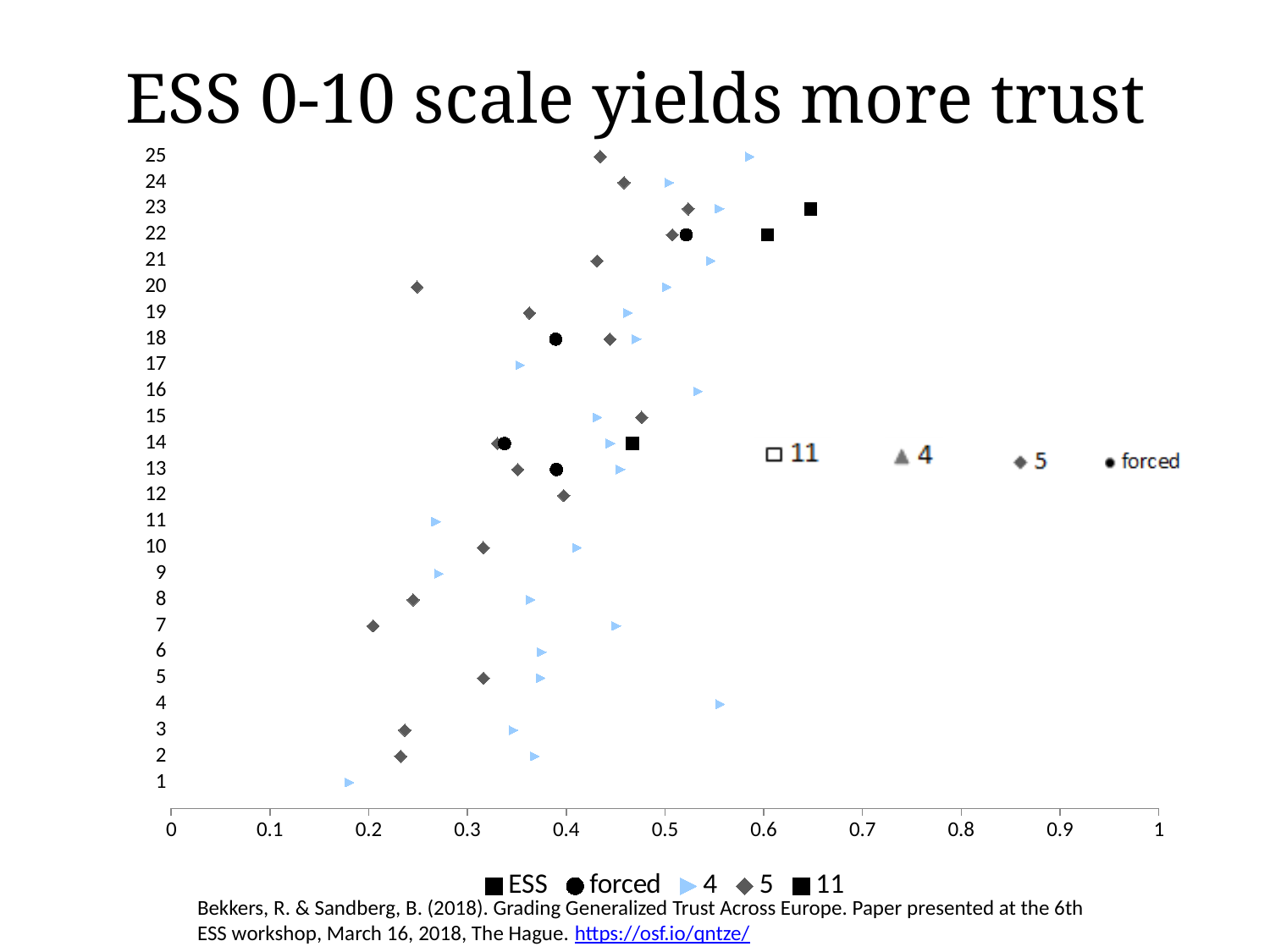
Is the value of the '4' series for category 4 greater or less than 0.5? greater How many series does the legend below the chart list? 5 How many numbered categories are shown on the vertical axis? 25 For category 23, which series has the larger value: '11' or '5'? 11 What kind of chart is shown on the slide? scatter chart Is the value of the '4' series for category 1 greater or less than 0.2? less Which series is plotted with light blue triangle markers? 4 Is the value of the '11' series for category 23 greater or less than 0.6? greater What is the title of the chart? ESS 0-10 scale yields more trust For which category does the '11' series reach its highest value? 23